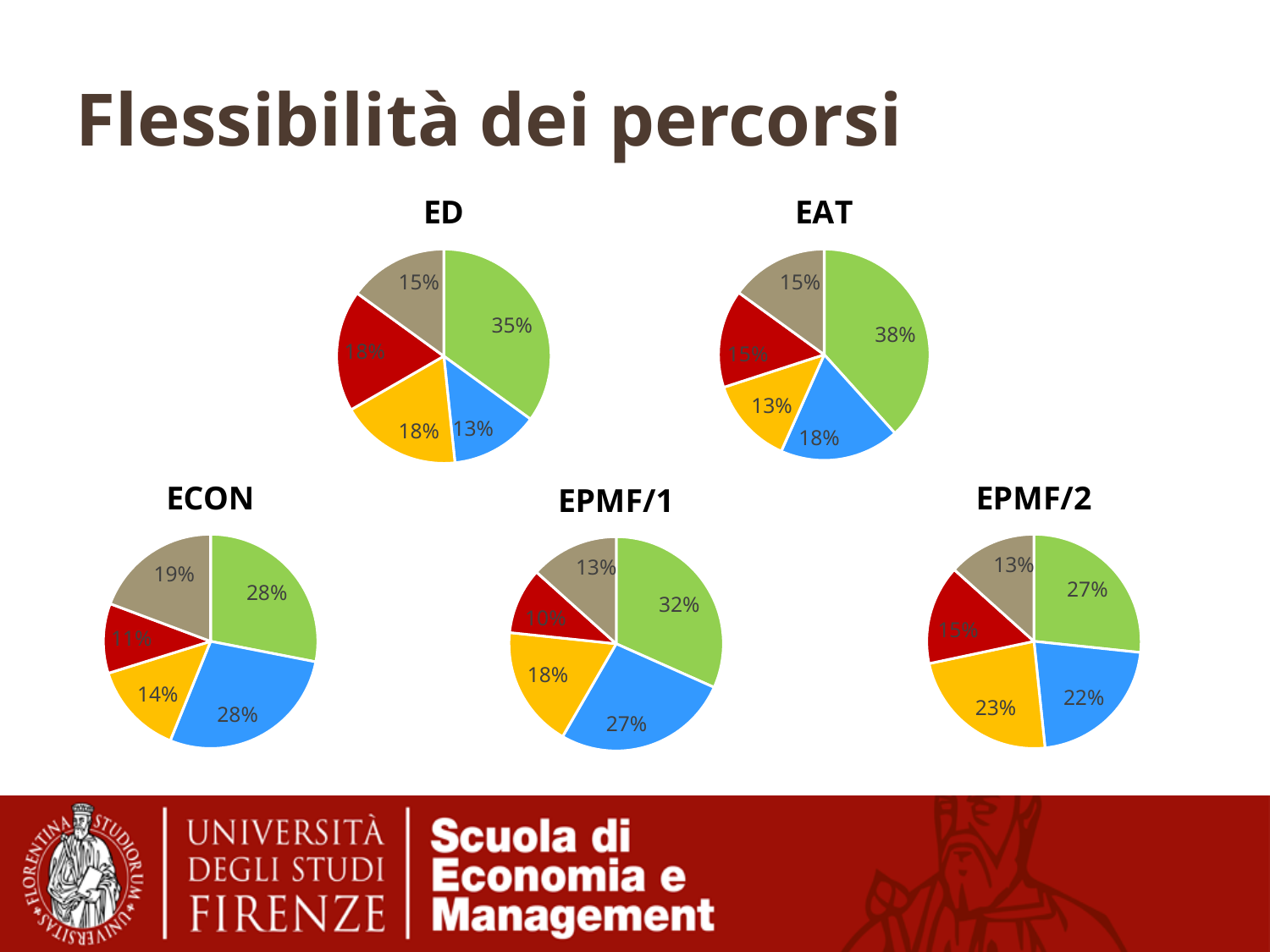
How many slices does the ECON pie chart have? 5 In the EAT pie chart, what is the value of the largest slice? 38% In the ED pie chart, what percentage does the blue slice represent? 13% In the EPMF/2 pie chart, what is the difference between the green slice and the red slice? 12% In the ECON pie chart, what percentage does the grey slice represent? 19% In the EPMF/1 pie chart, what is the value of the smallest slice? 10% How many pie charts are shown on the slide? 5 In the EPMF/1 pie chart, which is larger, the green slice or the blue slice? the green slice In the ED pie chart, what percentage does the green slice represent? 35% What kind of chart is used for EPMF/2? pie chart In the EPMF/2 pie chart, what percentage does the yellow slice represent? 23% In the EAT pie chart, what is the difference between the green slice and the blue slice? 20%